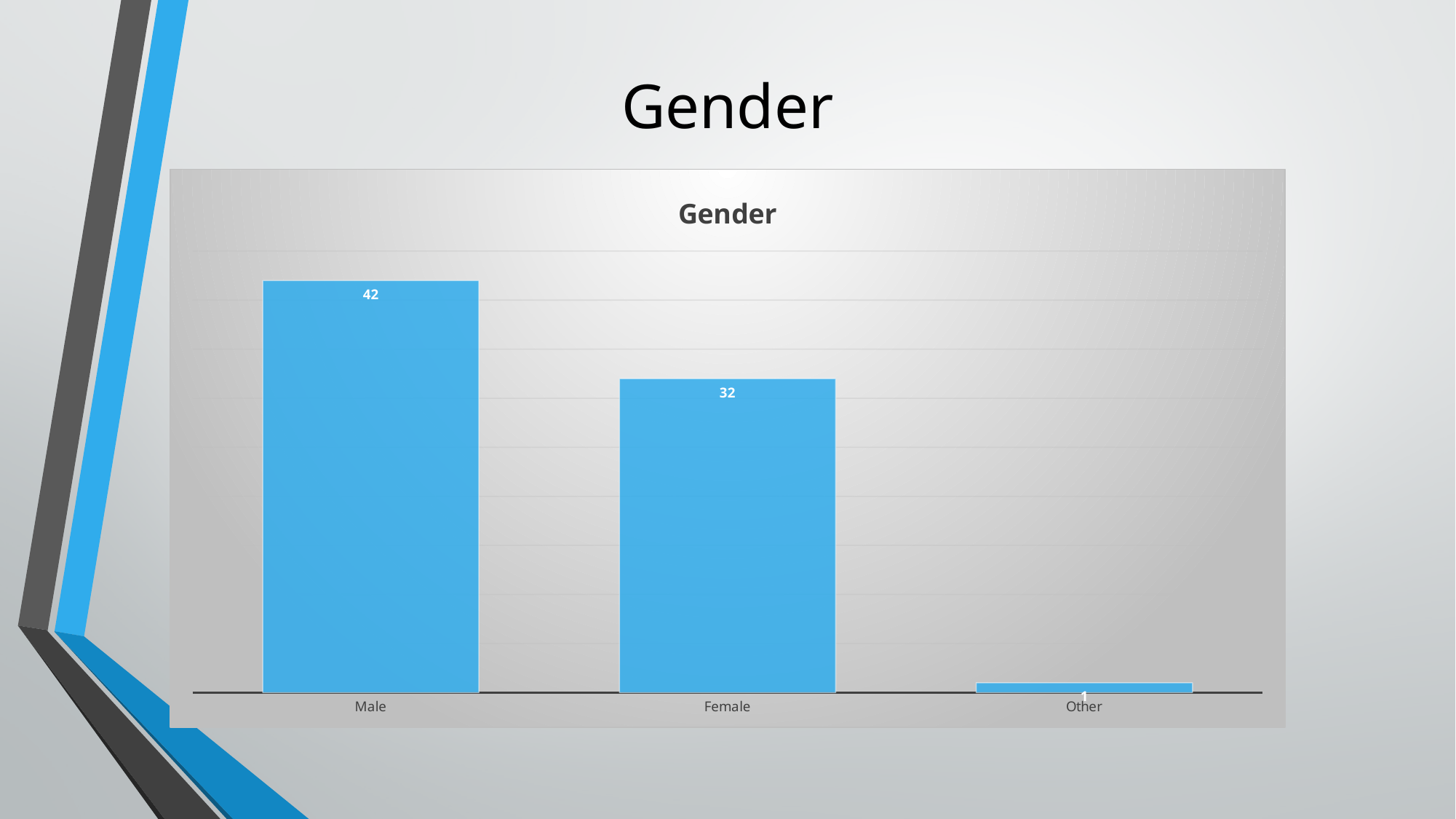
What is the difference between the values for Female and Other? 31 How many categories are shown on the x axis? 3 What kind of chart is shown on the slide? Bar chart Do the values rise or fall from left to right along the x axis? Fall What is the value for Male? 42 Which category has the lowest value? Other Which category has the highest value? Male What is the value for Female? 32 What is the difference between the values for Male and Female? 10 Which is larger, the value for Male or the value for Female? Male What is the value for Other? 1 What is the title of the chart? Gender